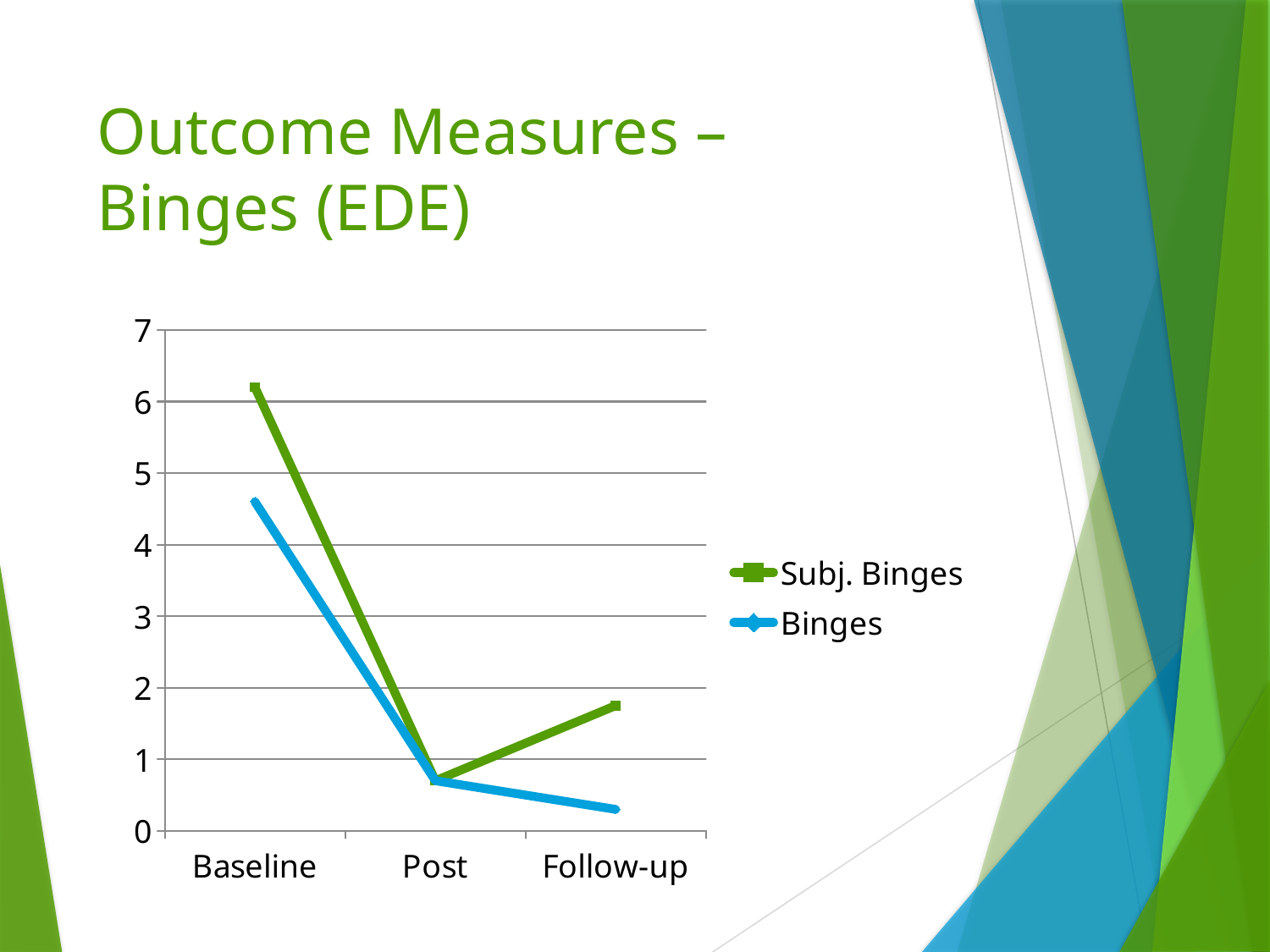
Is the value for Subj. Binges at Follow-up greater or less than 2? less At Follow-up, which series has the larger value, Subj. Binges or Binges? Subj. Binges How many categories are shown on the x axis? 3 At Baseline, which series has the larger value, Subj. Binges or Binges? Subj. Binges Is the value for Binges at Baseline greater or less than 5? less What kind of chart is shown on the slide? line chart At which time point is the Binges series lowest? Follow-up Does the Binges series rise or fall from Baseline to Follow-up? fall How many series does the legend list? 2 Is the value for Binges at Follow-up greater or less than 1? less At which time point is the Subj. Binges series highest? Baseline